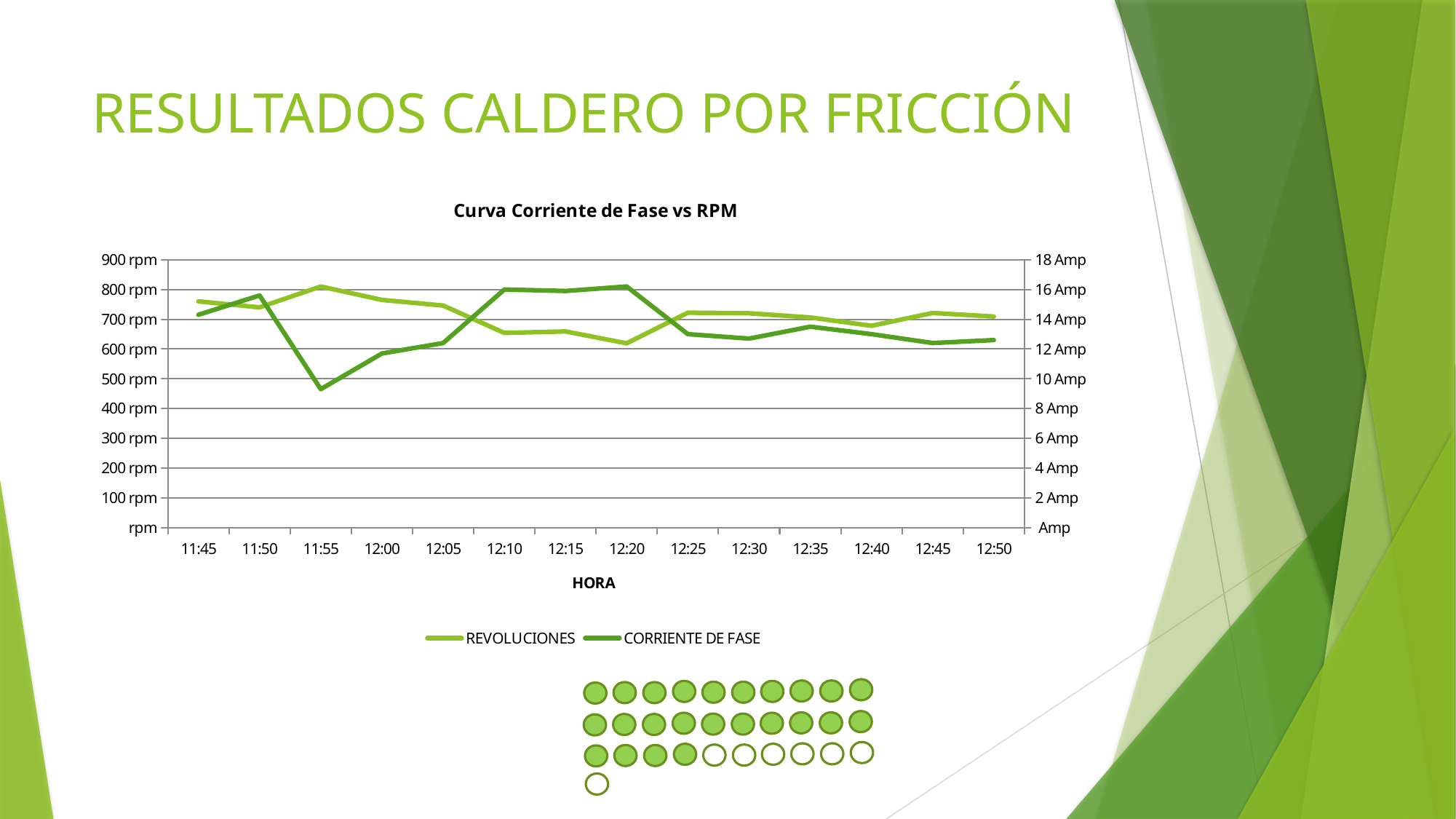
How many series does the legend list? 2 What is the title of the chart? Curva Corriente de Fase vs RPM Is the value for CORRIENTE DE FASE at 11:55 greater or less than 10 Amp? less Is the value for REVOLUCIONES at 12:20 greater or less than 700 rpm? less At which time does REVOLUCIONES reach its highest value? 11:55 Does CORRIENTE DE FASE rise or fall between 11:50 and 11:55? fall At which time does REVOLUCIONES reach its lowest value? 12:20 Is the value for CORRIENTE DE FASE at 12:20 greater or less than 14 Amp? greater At which time does CORRIENTE DE FASE reach its lowest value? 11:55 Which is larger for CORRIENTE DE FASE: the value at 11:50 or the value at 11:55? 11:50 What kind of chart is shown on the slide? line chart How many time points are plotted along the x axis? 14